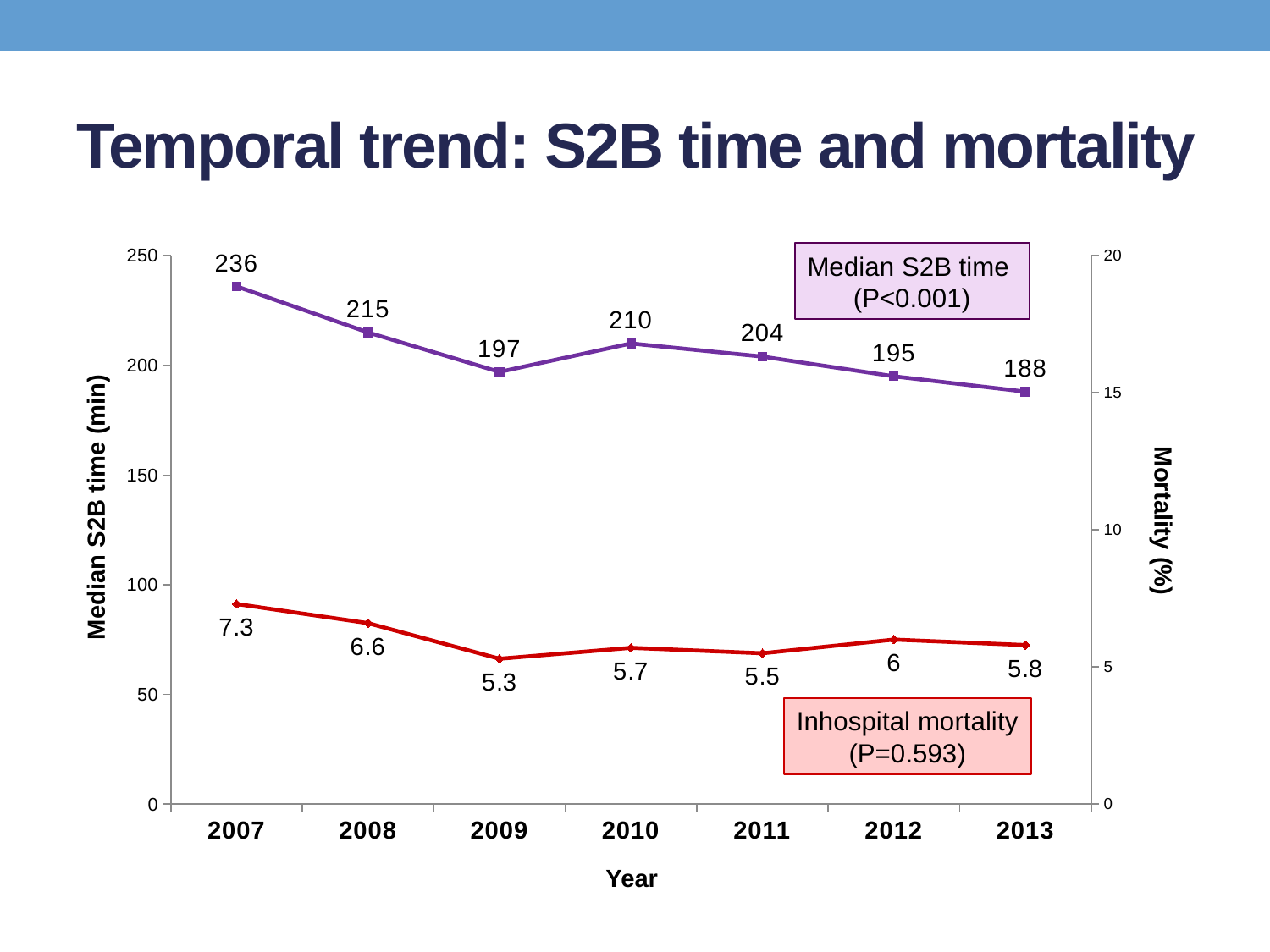
Does the median S2B time generally rise or fall from 2007 to 2013? fall Which year has the highest median S2B time? 2007 What is the inhospital mortality in 2012? 6 What is the median S2B time in 2013? 188 Which year has the higher median S2B time, 2009 or 2010? 2010 What kind of chart is shown on the slide? line chart What is the difference in median S2B time between 2007 and 2013? 48 What is the median S2B time in 2007? 236 How many years are shown on the x axis? 7 What is the title of the chart? Temporal trend: S2B time and mortality Is the median S2B time in 2011 greater or less than 200? greater Which year has the lowest inhospital mortality? 2009